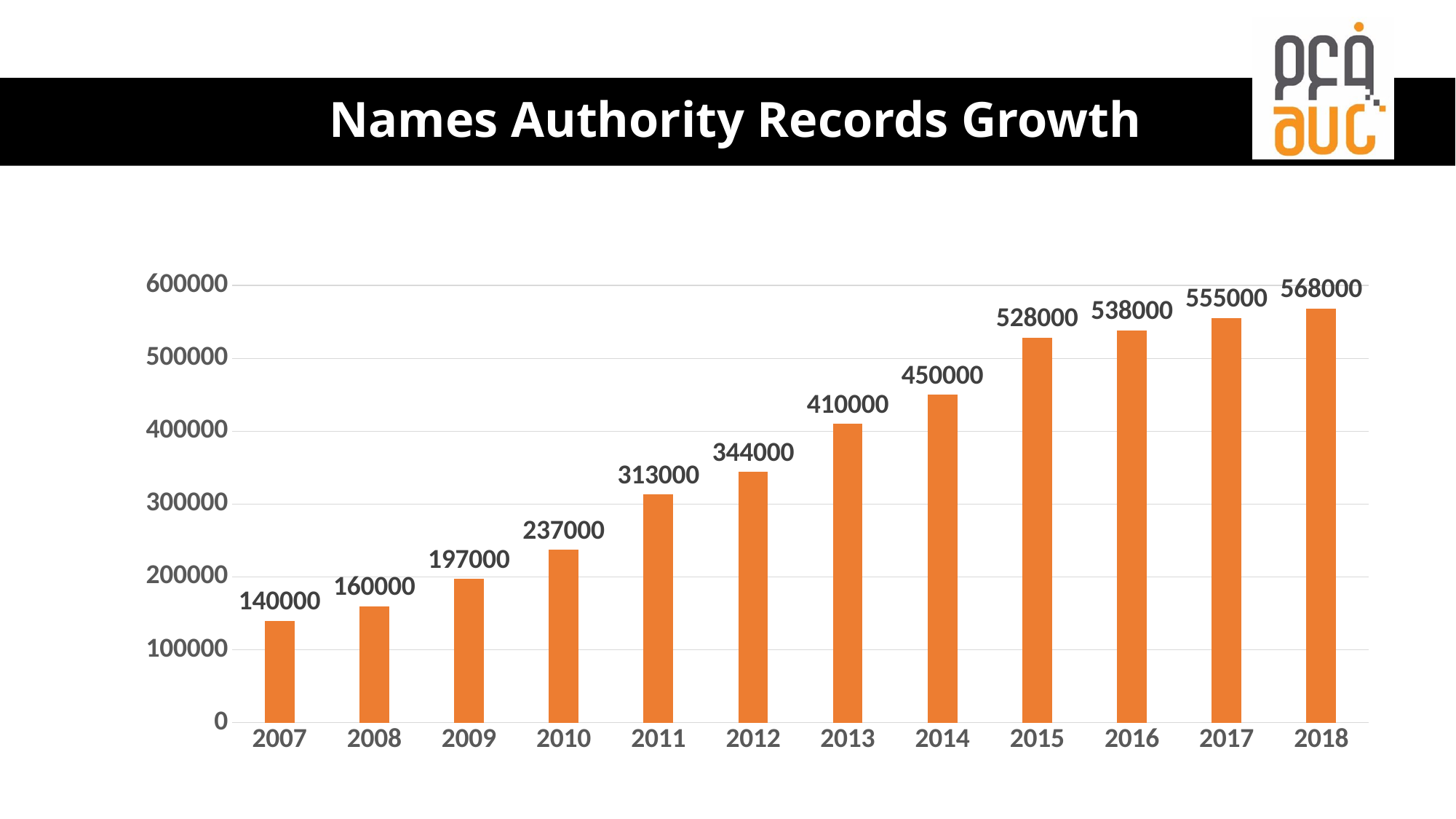
Which year has the highest value? 2018 Do the values rise or fall from 2007 to 2018? rise What is the value for 2013? 410000 What is the value for 2016? 538000 What is the difference between the values for 2015 and 2014? 78000 Which is larger, the value for 2011 or the value for 2012? 2012 What is the value for 2007? 140000 Is the value for 2010 greater or less than 200000? greater What is the difference between the values for 2018 and 2007? 428000 How many years are shown on the x axis? 12 What kind of chart is shown on the slide? bar chart Which year has the lowest value? 2007